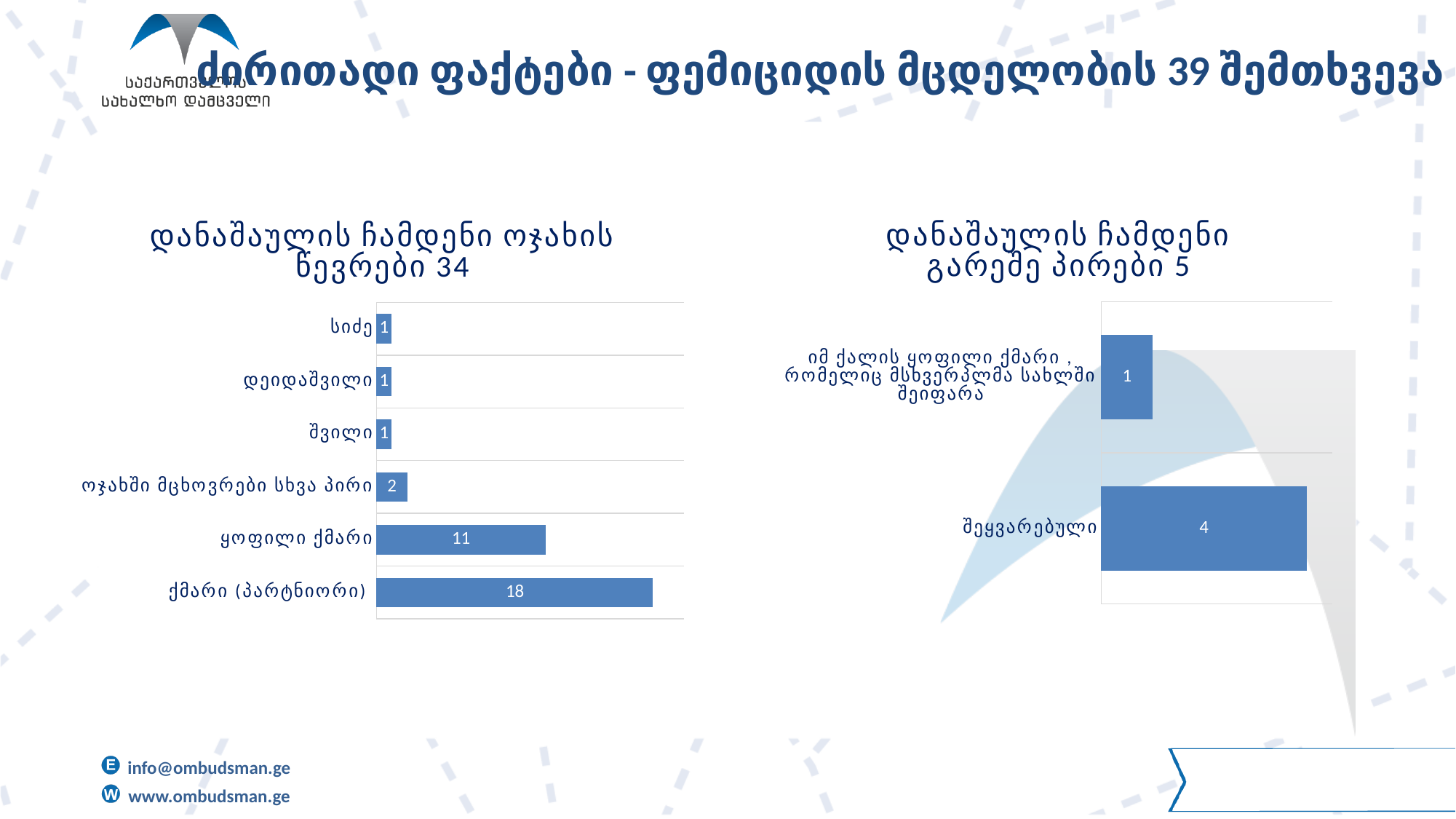
In the right chart (დანაშაულის ჩამდენი გარეშე პირები 5), what is the value for შეყვარებული? 4 In the left chart, which category has the highest value? ქმარი (პარტნიორი) In the left chart, how many categories are shown? 6 In the right chart, which category has the lowest value? იმ ქალის ყოფილი ქმარი, რომელიც მსხვერპლმა სახლში შეიფარა In the right chart, how many categories are shown? 2 What type of chart is the left chart? Bar chart In the left chart, what is the value for ყოფილი ქმარი? 11 In the left chart (დანაშაულის ჩამდენი ოჯახის წევრები 34), what is the value for ქმარი (პარტნიორი)? 18 In the left chart, what is the value for ოჯახში მცხოვრები სხვა პირი? 2 In the left chart, what is the difference between the values for ქმარი (პარტნიორი) and ყოფილი ქმარი? 7 In the right chart, what is the difference between the values for შეყვარებული and იმ ქალის ყოფილი ქმარი, რომელიც მსხვერპლმა სახლში შეიფარა? 3 What is the title of the left chart? დანაშაულის ჩამდენი ოჯახის წევრები 34